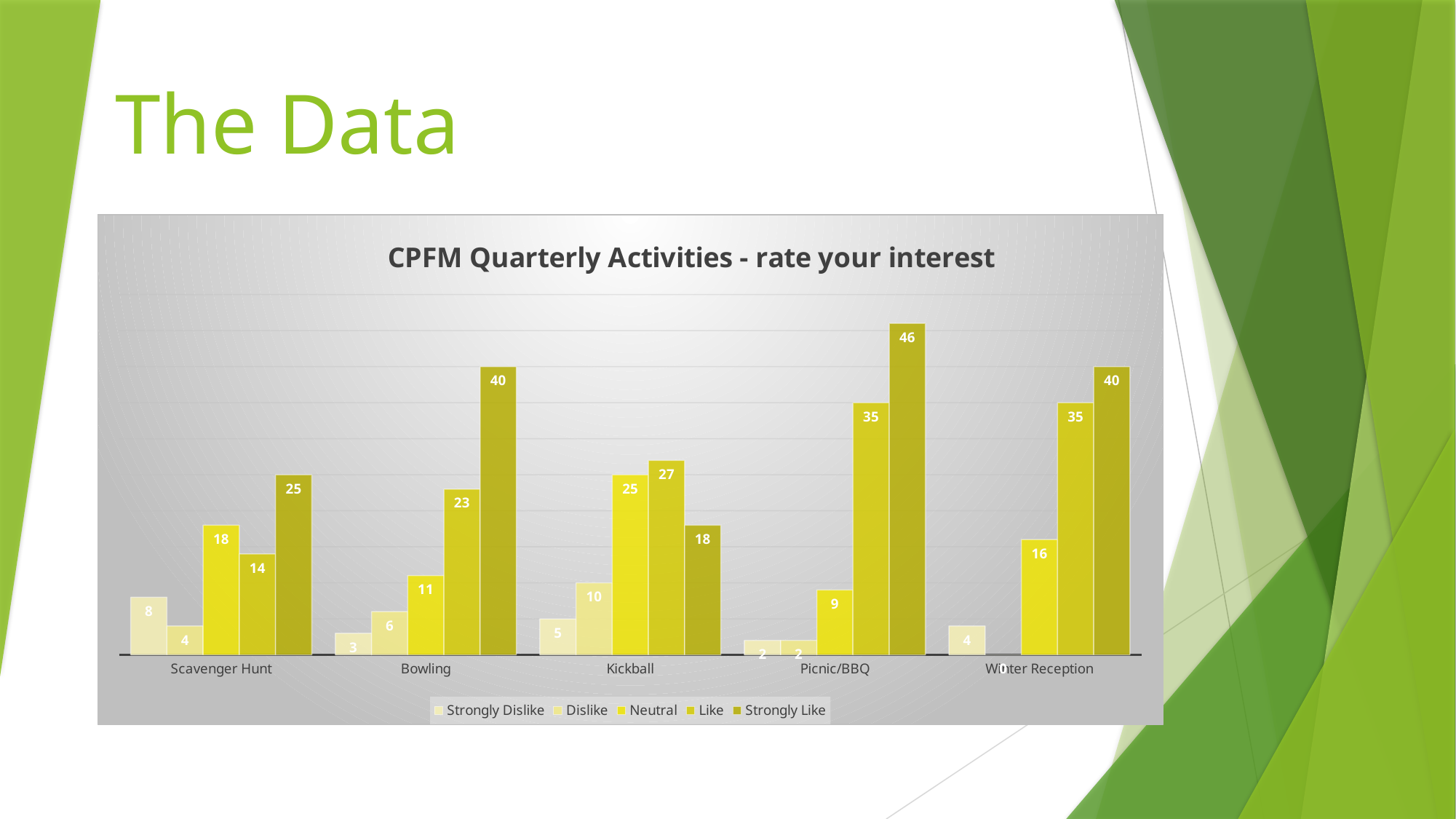
What is the Strongly Dislike value for Scavenger Hunt? 8 What is the difference between the Neutral and Like values for Scavenger Hunt? 4 Which activity has the lowest Strongly Like value? Kickball How many activities are shown on the x axis? 5 What is the difference between the Strongly Like and Like values for Picnic/BBQ? 11 What is the Neutral value for Kickball? 25 What is the Strongly Like value for Bowling? 40 Which activity has the highest Strongly Like value? Picnic/BBQ How many series does the legend list? 5 For Kickball, which is larger: the Like value or the Strongly Like value? Like What kind of chart is shown on the slide? Bar chart What is the Like value for Picnic/BBQ? 35